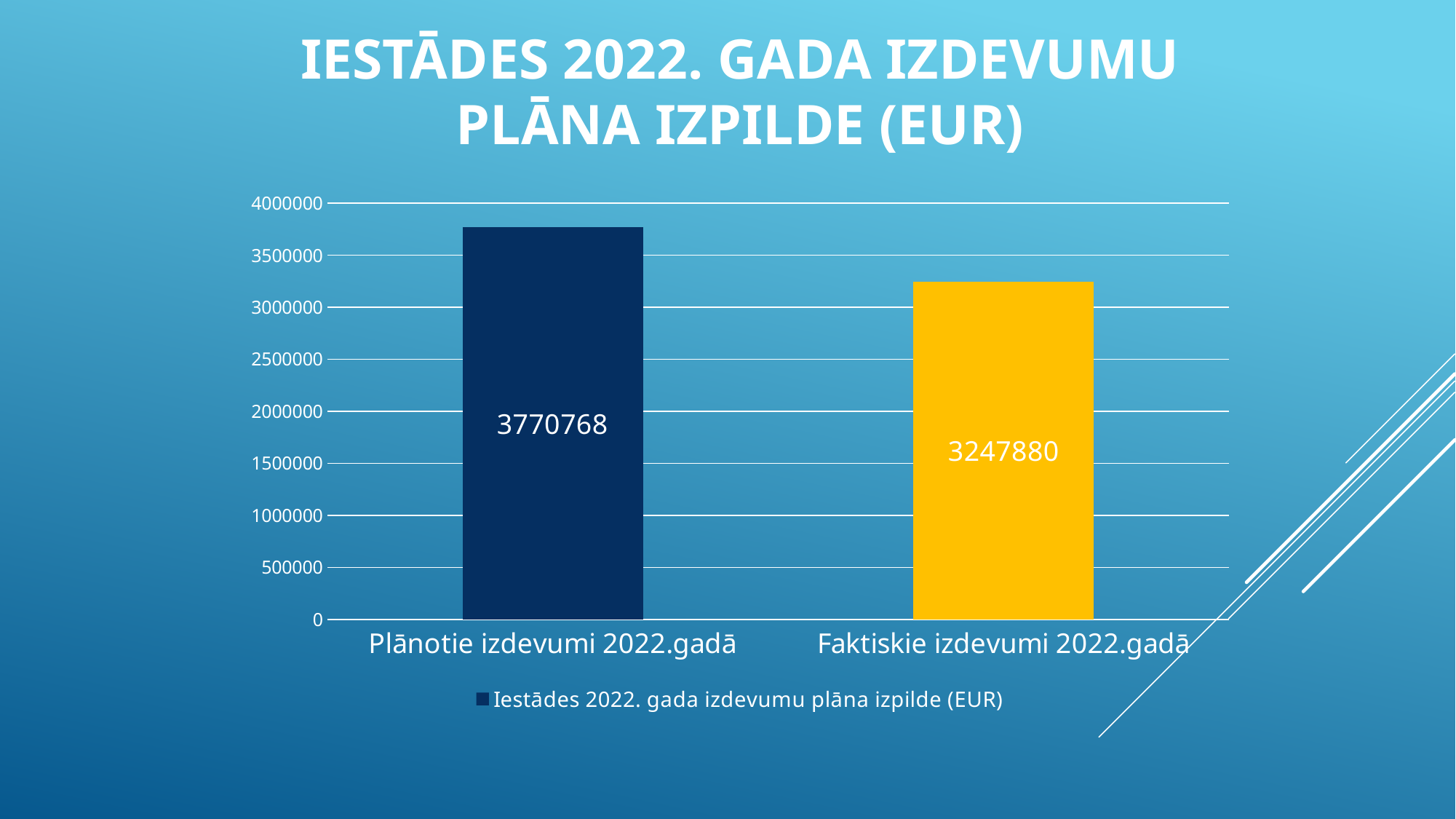
What kind of chart is shown on the slide? bar chart How many categories are shown on the chart? 2 Is the value for Plānotie izdevumi 2022.gadā greater or less than 3500000? greater Which category has the highest value? Plānotie izdevumi 2022.gadā Is the value for Faktiskie izdevumi 2022.gadā greater or less than 3500000? less Which is larger, Plānotie izdevumi 2022.gadā or Faktiskie izdevumi 2022.gadā? Plānotie izdevumi 2022.gadā What is the title of the chart? Iestādes 2022. gada izdevumu plāna izpilde (EUR) What is the value for Faktiskie izdevumi 2022.gadā? 3247880 Which category has the lowest value? Faktiskie izdevumi 2022.gadā How many series does the legend list? 1 What is the difference between Plānotie izdevumi 2022.gadā and Faktiskie izdevumi 2022.gadā? 522888 What is the value for Plānotie izdevumi 2022.gadā? 3770768